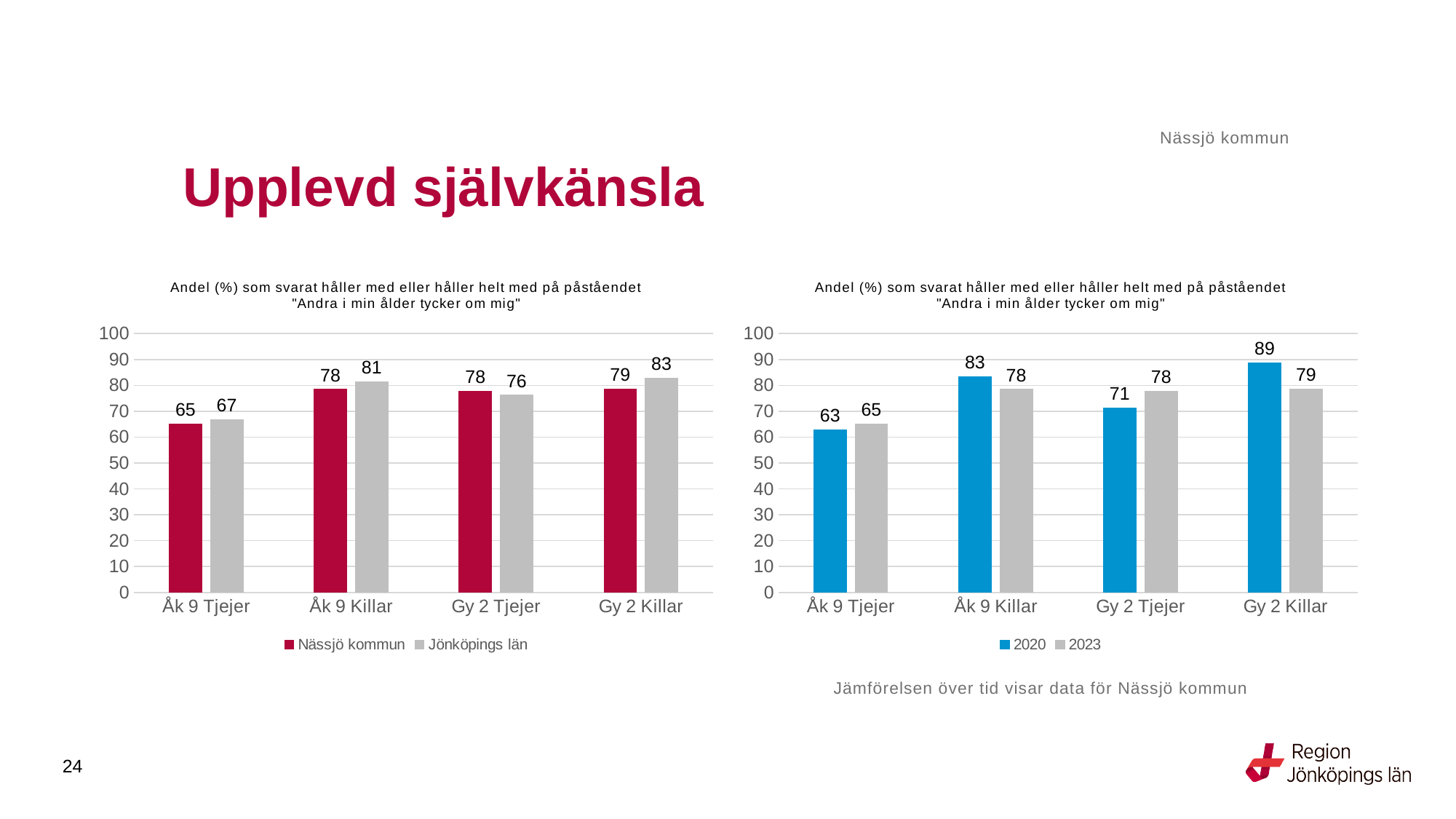
In the right chart, what is the value for 2023 for Åk 9 Tjejer? 65 What kind of chart is the left chart? Bar chart In the left chart, what is the value for Jönköpings län for Gy 2 Killar? 83 In the right chart, what is the difference between the 2020 and 2023 values for Gy 2 Killar? 10 In the right chart, which category has the highest value for 2020? Gy 2 Killar How many series does the legend of the right chart list? 2 How many categories are shown on the x axis of the left chart? 4 In the right chart, which is larger for Gy 2 Tjejer: 2020 or 2023? 2023 In the right chart, what is the value for 2020 for Gy 2 Killar? 89 In the left chart, which is larger for Gy 2 Tjejer: Nässjö kommun or Jönköpings län? Nässjö kommun In the left chart, which category has the lowest value for Nässjö kommun? Åk 9 Tjejer In the left chart, what is the value for Nässjö kommun for Åk 9 Tjejer? 65